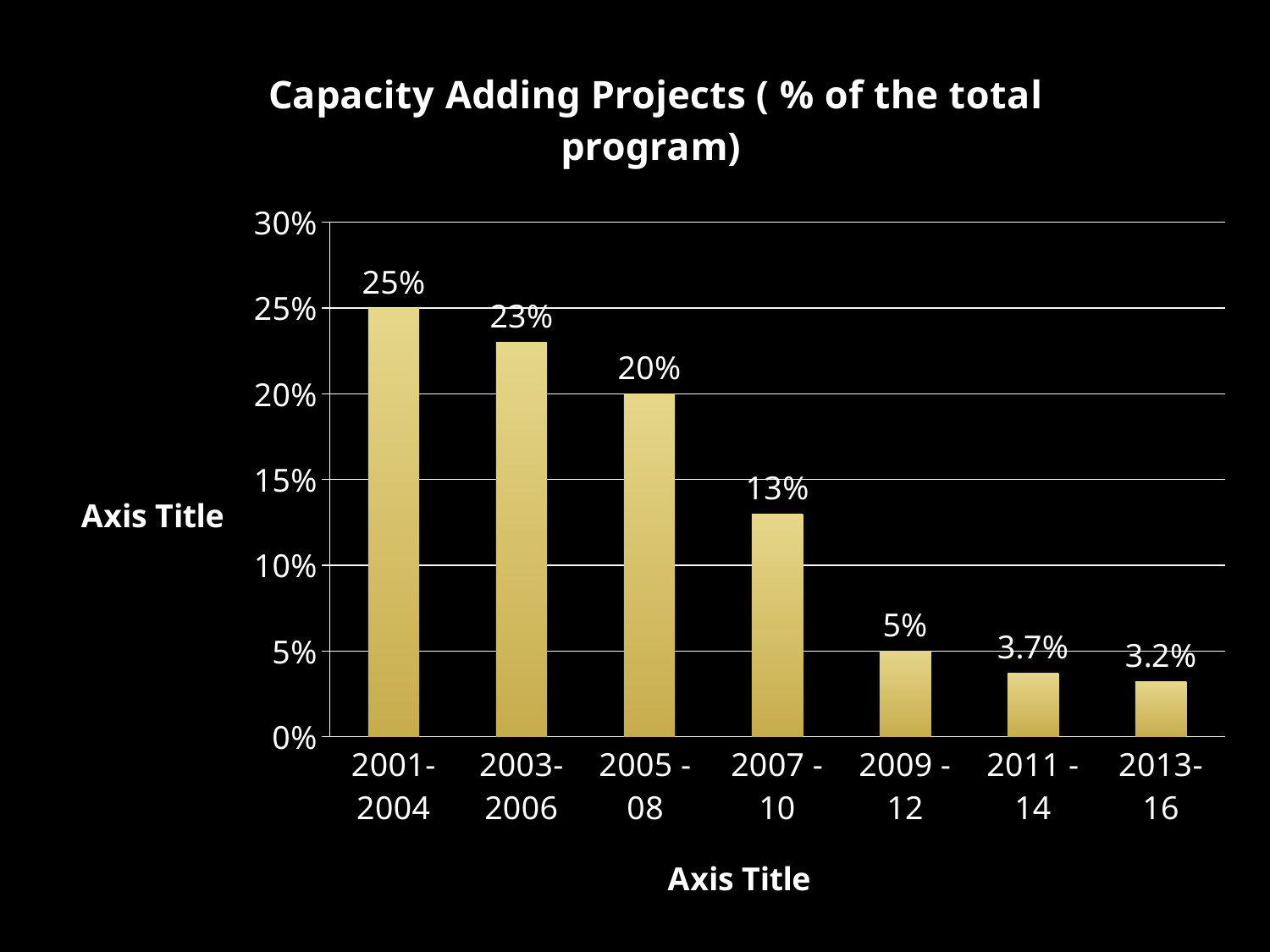
How many periods are shown on the x axis? 7 What is the difference between the values for 2001-2004 and 2005 - 08? 5% Which period has the highest value? 2001-2004 Do the values rise or fall from 2001-2004 to 2013-16? fall Is the value for 2007 - 10 greater or less than 10%? greater Which period has the lowest value? 2013-16 What is the value for 2001-2004? 25% Which is larger, the value for 2003-2006 or the value for 2007 - 10? 2003-2006 What is the value for 2013-16? 3.2% What is the value for 2007 - 10? 13% What kind of chart is this? bar chart What is the difference between the values for 2009 - 12 and 2011 - 14? 1.3%